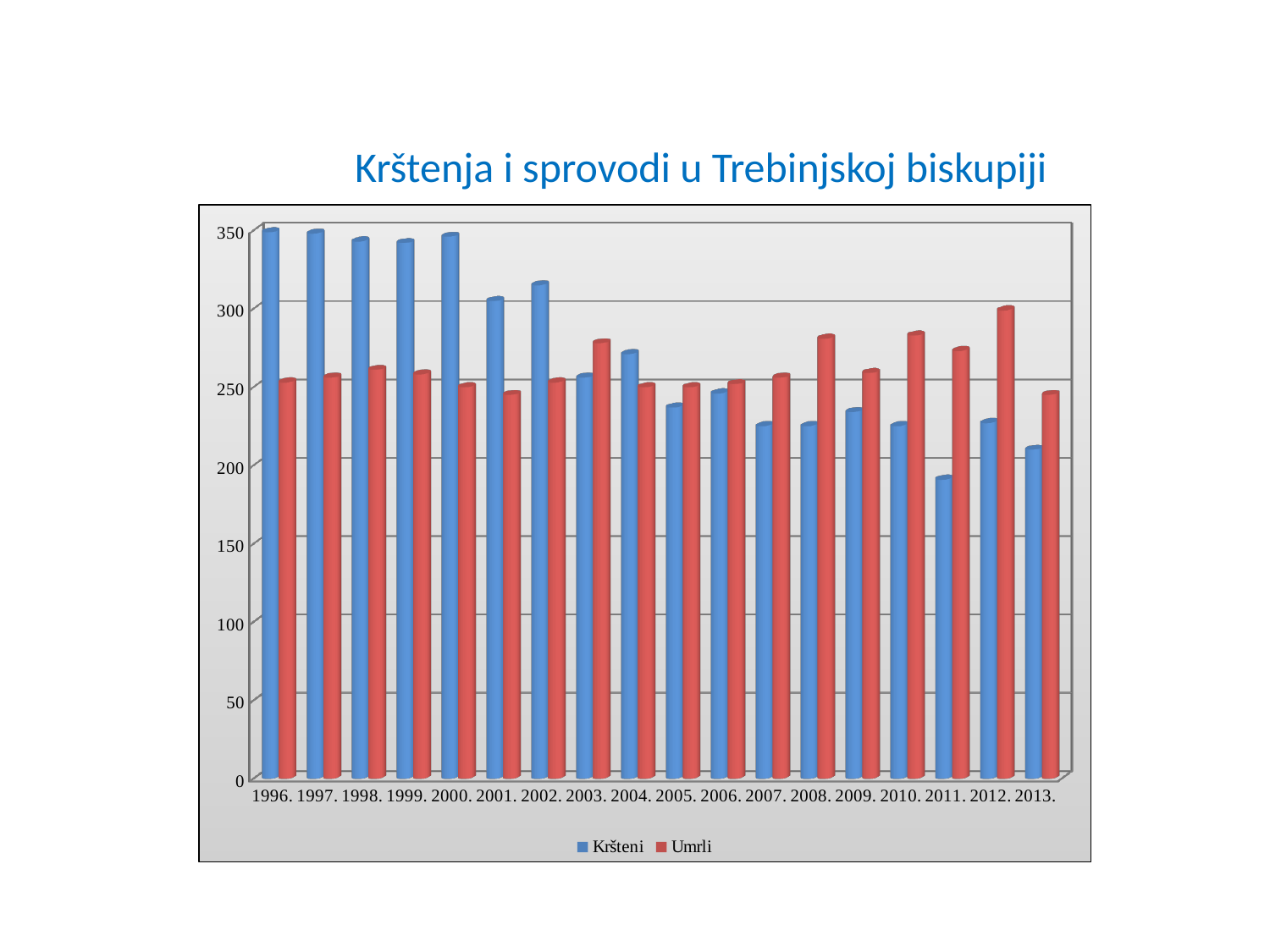
In 2000., which is larger, Kršteni or Umrli? Kršteni Do the values for Kršteni generally rise or fall from 1996. to 2013.? fall Is the value for Kršteni in 2001. greater or less than 300? greater Is the value for Umrli in 2003. greater or less than 250? greater What is the title of the chart? Krštenja i sprovodi u Trebinjskoj biskupiji Is the value for Kršteni in 2011. greater or less than 200? less Which year has the highest value for Umrli? 2012. What kind of chart is shown on the slide? bar chart In 2011., which is larger, Kršteni or Umrli? Umrli Which year has the lowest value for Kršteni? 2011. How many series does the legend list? 2 How many years are shown on the x axis? 18